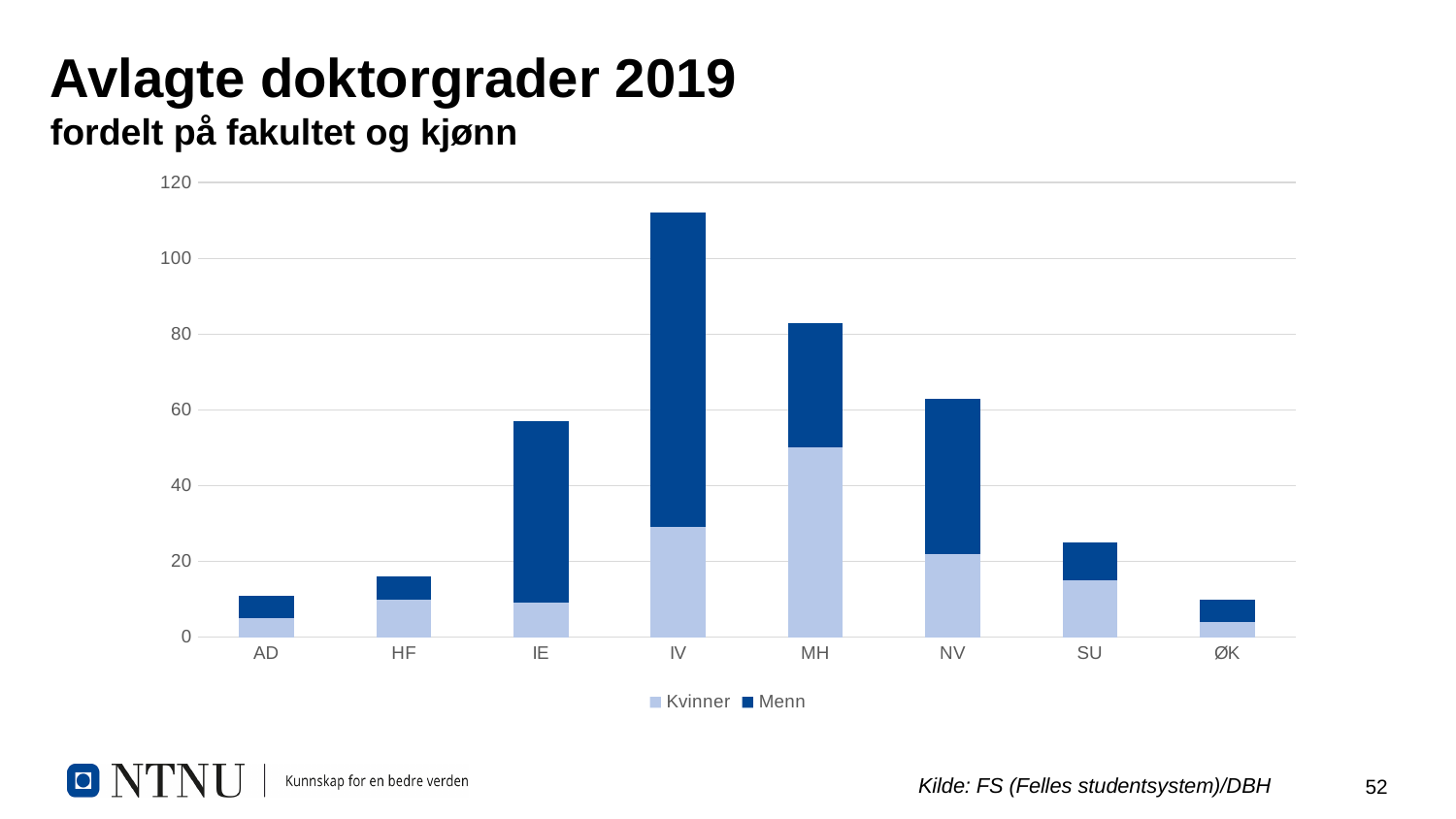
Which faculty has the largest Kvinner (women) segment? MH Is the total bar for IV greater or less than 100? greater How many faculties (categories) are shown on the x axis? 8 Which faculty has the larger Menn (men) segment, IV or MH? IV Which has the taller total bar, IV or MH? IV Which faculty has the tallest stacked bar (most doctoral degrees in total)? IV What kind of chart is shown on the slide? Stacked bar chart What are the two series named in the legend? Kvinner and Menn Is the total bar for HF greater or less than 20? less How many series does the legend list? 2 Is the Kvinner segment for MH greater or less than 40? greater